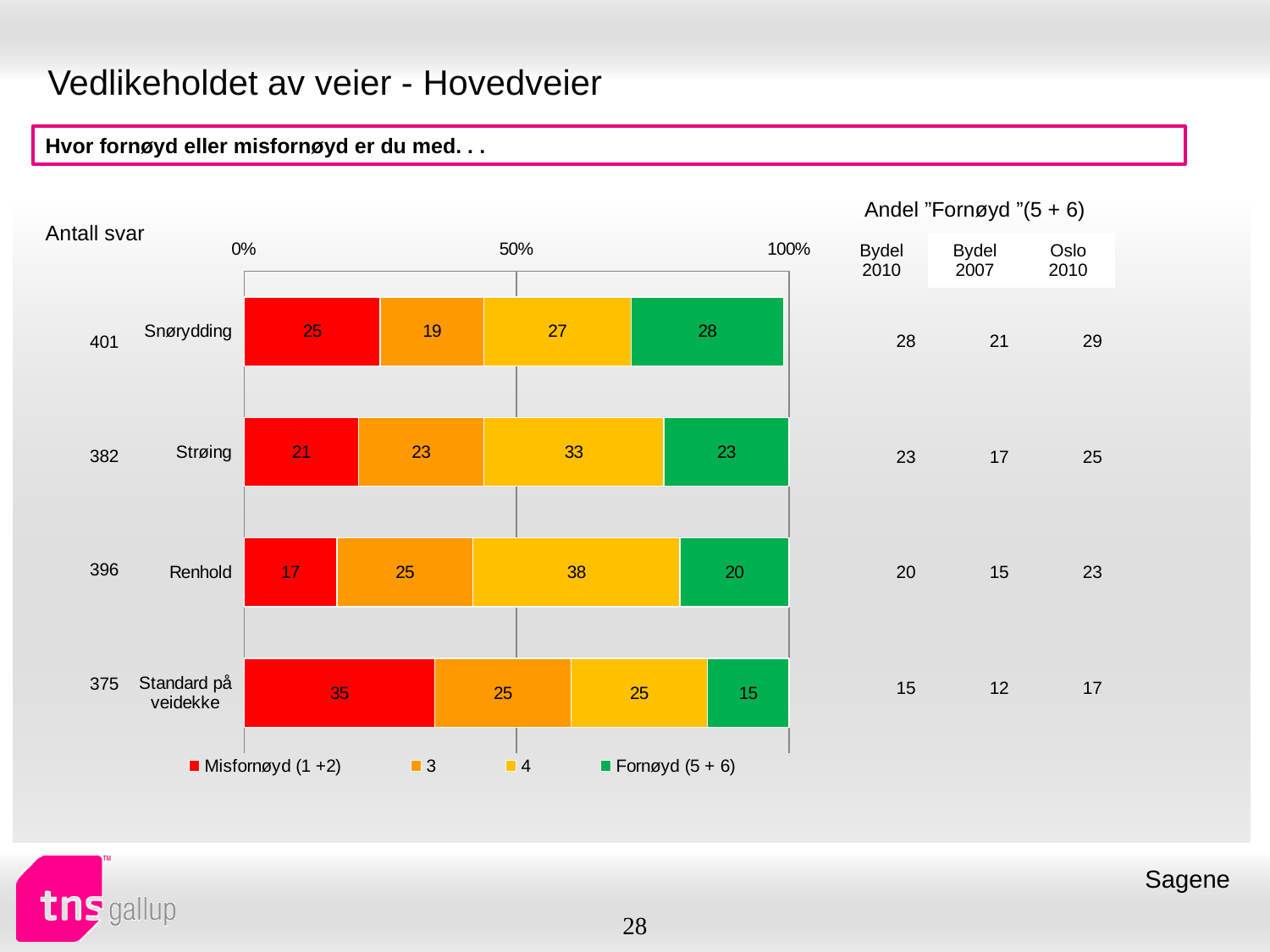
What kind of chart is shown on the slide? Stacked bar chart How many categories are plotted in the chart? 4 What is the value of the '4' segment for Renhold? 38 Which category has the lowest Misfornøyd (1 +2) value? Renhold What is the total of the stacked bar for Strøing? 100 What is the difference between the Misfornøyd (1 +2) values for Standard på veidekke and Renhold? 18 Which category has the highest Fornøyd (5 + 6) value? Snørydding What is the value of the '3' segment for Strøing? 23 What is the value of the Fornøyd (5 + 6) segment for Snørydding? 28 How many series does the legend list? 4 Which is larger: the '4' segment for Strøing or the '4' segment for Snørydding? Strøing What is the value of the Misfornøyd (1 +2) segment for Standard på veidekke? 35